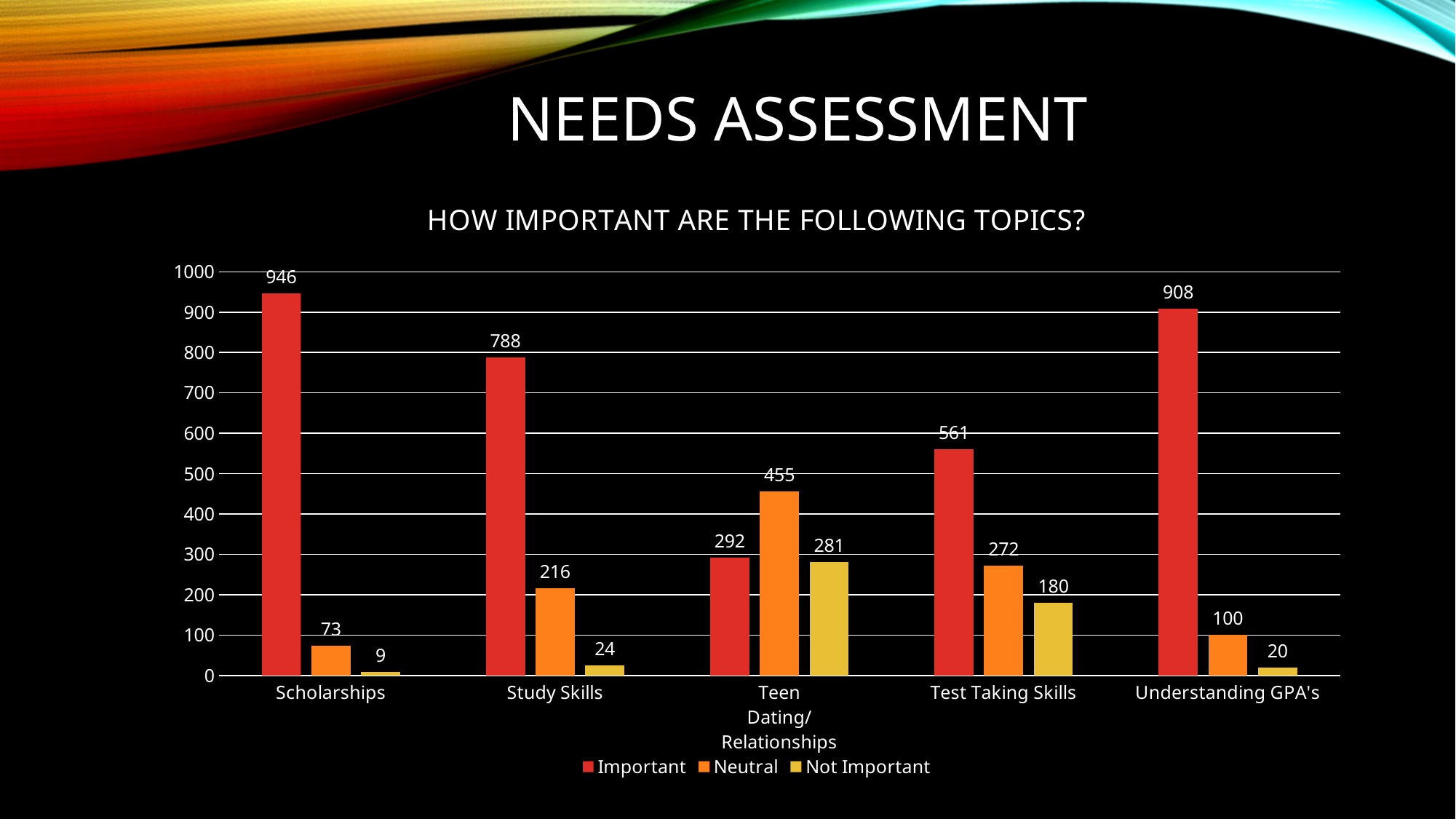
What is the Important value for Scholarships? 946 What is the Neutral value for Teen Dating/Relationships? 455 Which is larger for Teen Dating/Relationships: the Important value or the Neutral value? Neutral What is the title of the chart? How important are the following topics? Is the Important value for Study Skills greater or less than 700? greater What kind of chart is shown on the slide? Bar chart How many series does the legend list? 3 What is the Not Important value for Test Taking Skills? 180 What is the difference between the Important values for Scholarships and Understanding GPA's? 38 Which topic has the highest Important value? Scholarships How many topics are shown on the x axis? 5 Which topic has the lowest Not Important value? Scholarships